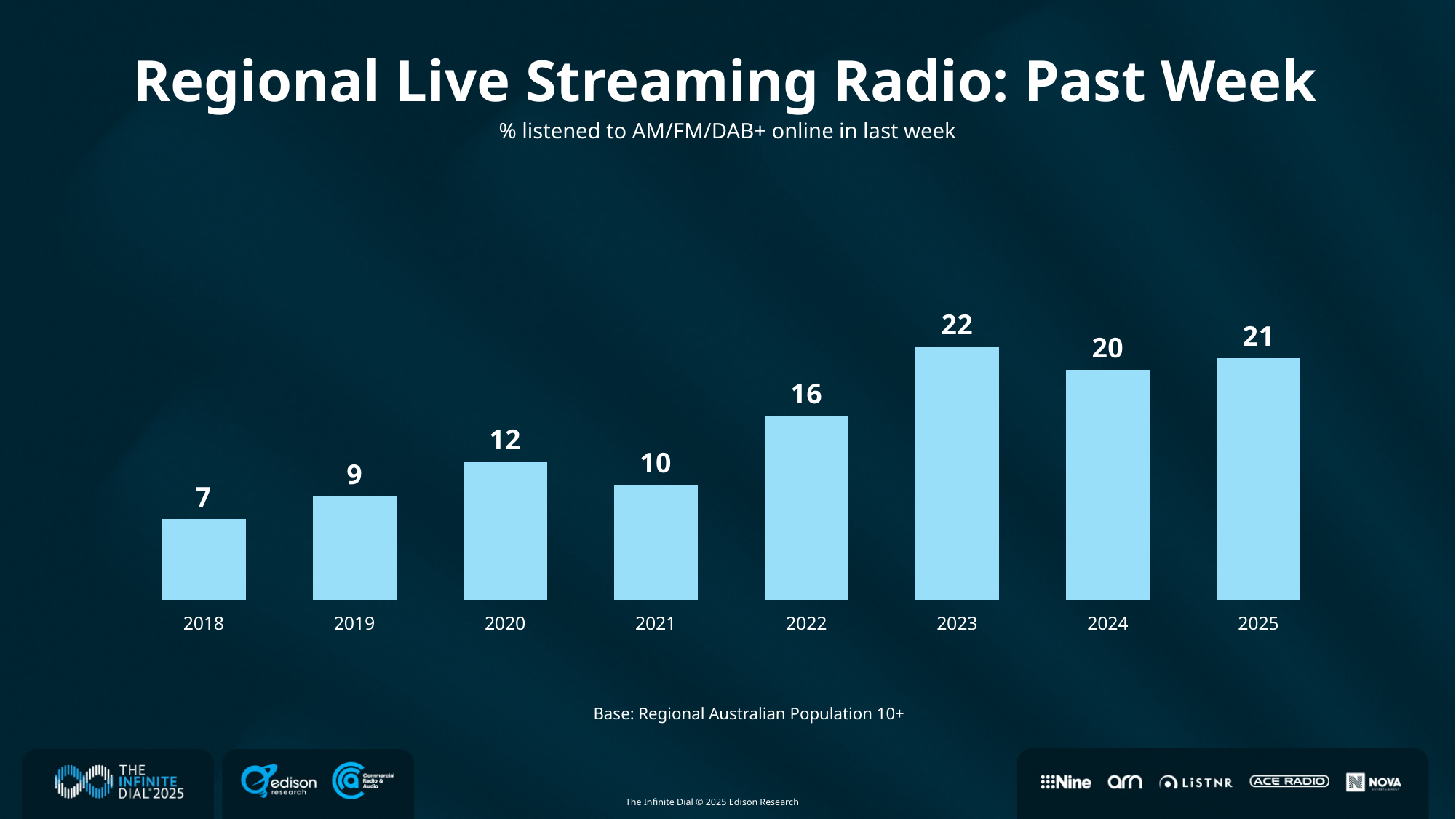
Do the values generally rise or fall from 2018 to 2023? Rise Which is larger, the value for 2020 or the value for 2021? 2020 What is the difference between the values for 2023 and 2018? 15 What is the value for 2021? 10 How many years are shown on the chart? 8 What is the value for 2018? 7 Which year has the lowest value? 2018 What kind of chart is shown on the slide? Bar chart What is the difference between the values for 2025 and 2024? 1 What is the value for 2023? 22 What is the title of the chart? Regional Live Streaming Radio: Past Week Which year has the highest value? 2023